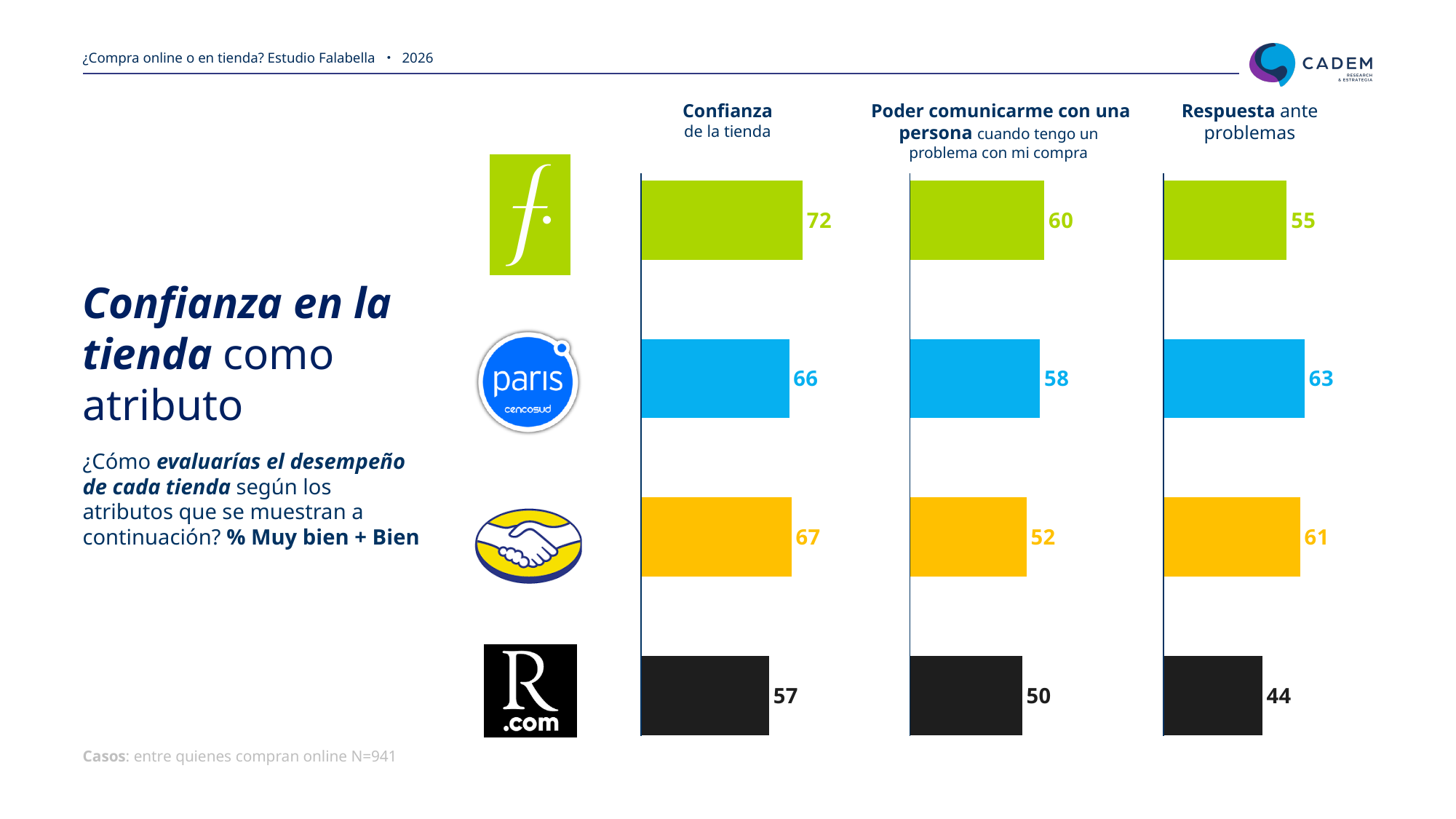
In the 'Respuesta ante problemas' chart, what is the value for paris? 63 What type of chart is used on this slide? Bar chart In the 'Respuesta ante problemas' chart, which row has the lowest value? R.com (bottom row) In the 'Confianza de la tienda' chart, what is the difference between the top row (72) and the bottom row R.com (57)? 15 How many stores (rows) are shown in each chart? 4 In the 'Respuesta ante problemas' chart, what is the difference between paris and the top row ('f' logo store)? 8 In the 'Poder comunicarme con una persona' chart, what is the value for the bottom row (R.com)? 50 In the 'Poder comunicarme con una persona' chart, which is larger: the value for paris or the value for the third row (handshake logo)? paris In the 'Confianza de la tienda' chart, what is the value for the top row (the 'f' logo store)? 72 In the 'Confianza de la tienda' chart, what is the value for paris? 66 In the 'Confianza de la tienda' chart, which row has the highest value? The top row ('f' logo store) How many attribute charts are shown on the slide? 3